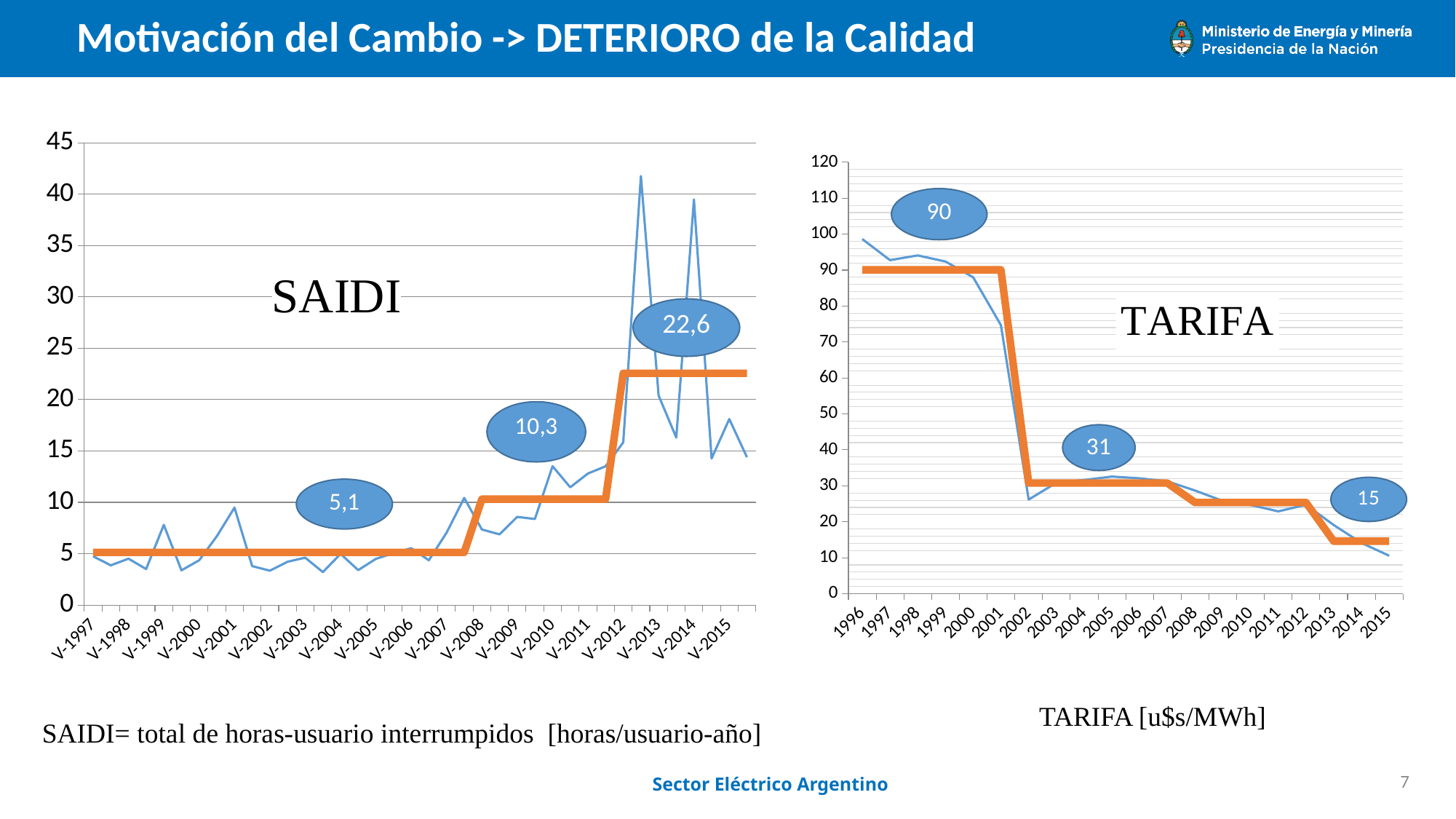
In the TARIFA chart, what value is shown in the label for the orange step level from 2013 onward? 15 What kind of chart is the TARIFA chart on the right? line chart In the SAIDI chart, what value is shown in the label for the lowest orange step level (V-1997 to V-2007)? 5,1 In the SAIDI chart, is the value for V-2013 greater or less than 35? less In the TARIFA chart, do the values generally rise or fall from 1996 to 2015? fall In the TARIFA chart, what value is shown in the label for the orange step level covering 2002 to 2007? 31 In the TARIFA chart, what is the difference between the labelled step values 90 and 15? 75 In the SAIDI chart, what value is shown in the label for the highest orange step level (from V-2012 onward)? 22,6 In the TARIFA chart, is the value for 2002 greater or less than 30? less In the TARIFA chart, in which year is the blue line at its highest? 1996 What kind of chart is the SAIDI chart on the left? line chart